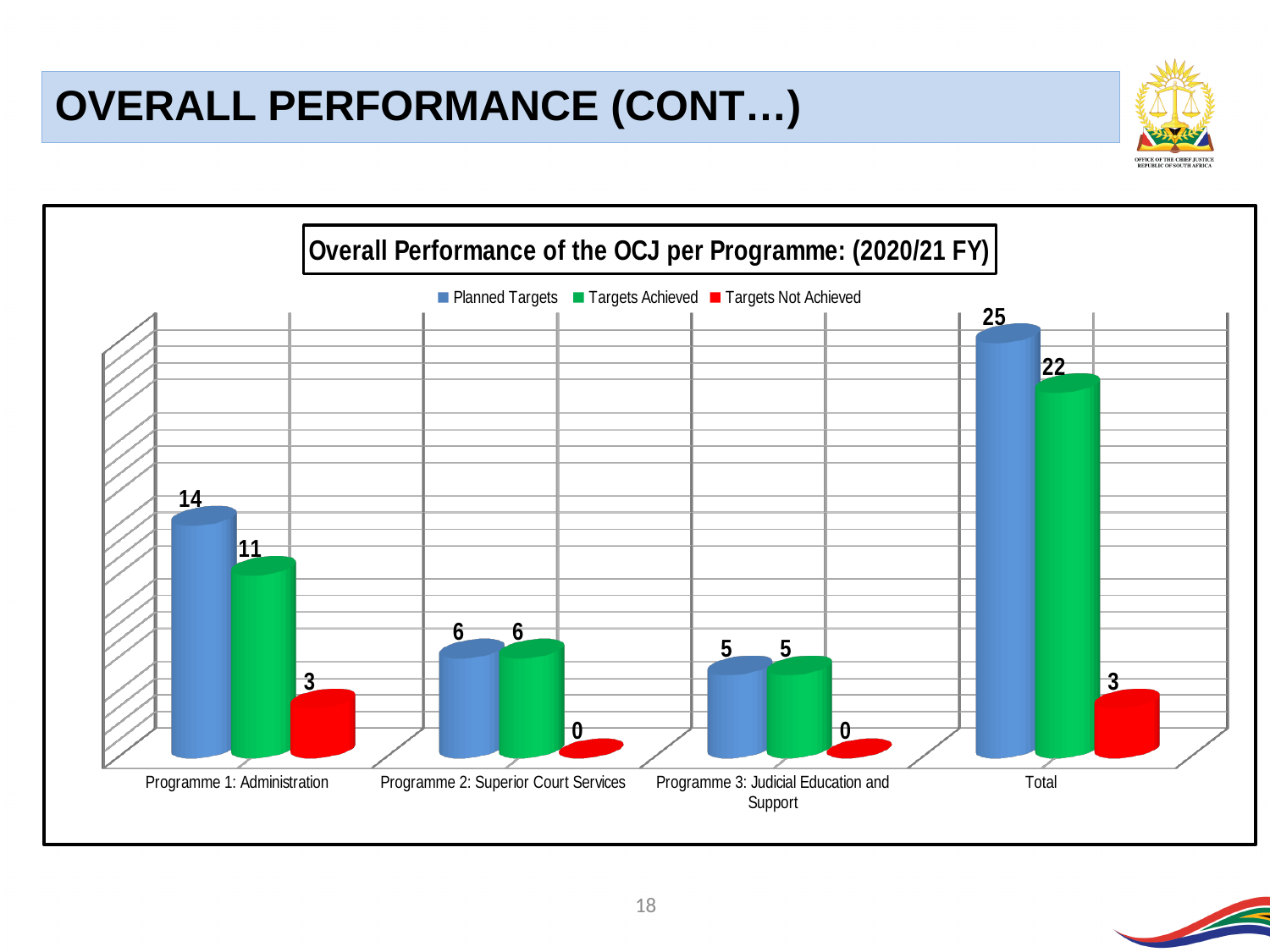
What is the value of Planned Targets for Programme 1: Administration? 14 What is the difference between Planned Targets and Targets Achieved for Programme 1: Administration? 3 Which colour represents Targets Not Achieved in the chart? Red How many series does the legend list? 3 What is the value of Targets Achieved for Total? 22 How many categories are shown on the x axis? 4 Which category has the highest Planned Targets value? Total What kind of chart is shown on the slide? Bar chart Excluding Total, which programme has the lowest Planned Targets value? Programme 3: Judicial Education and Support What is the value of Targets Not Achieved for Programme 2: Superior Court Services? 0 What is the title of the chart? Overall Performance of the OCJ per Programme: (2020/21 FY) Which is larger for Programme 1: Administration, Targets Achieved or Targets Not Achieved? Targets Achieved